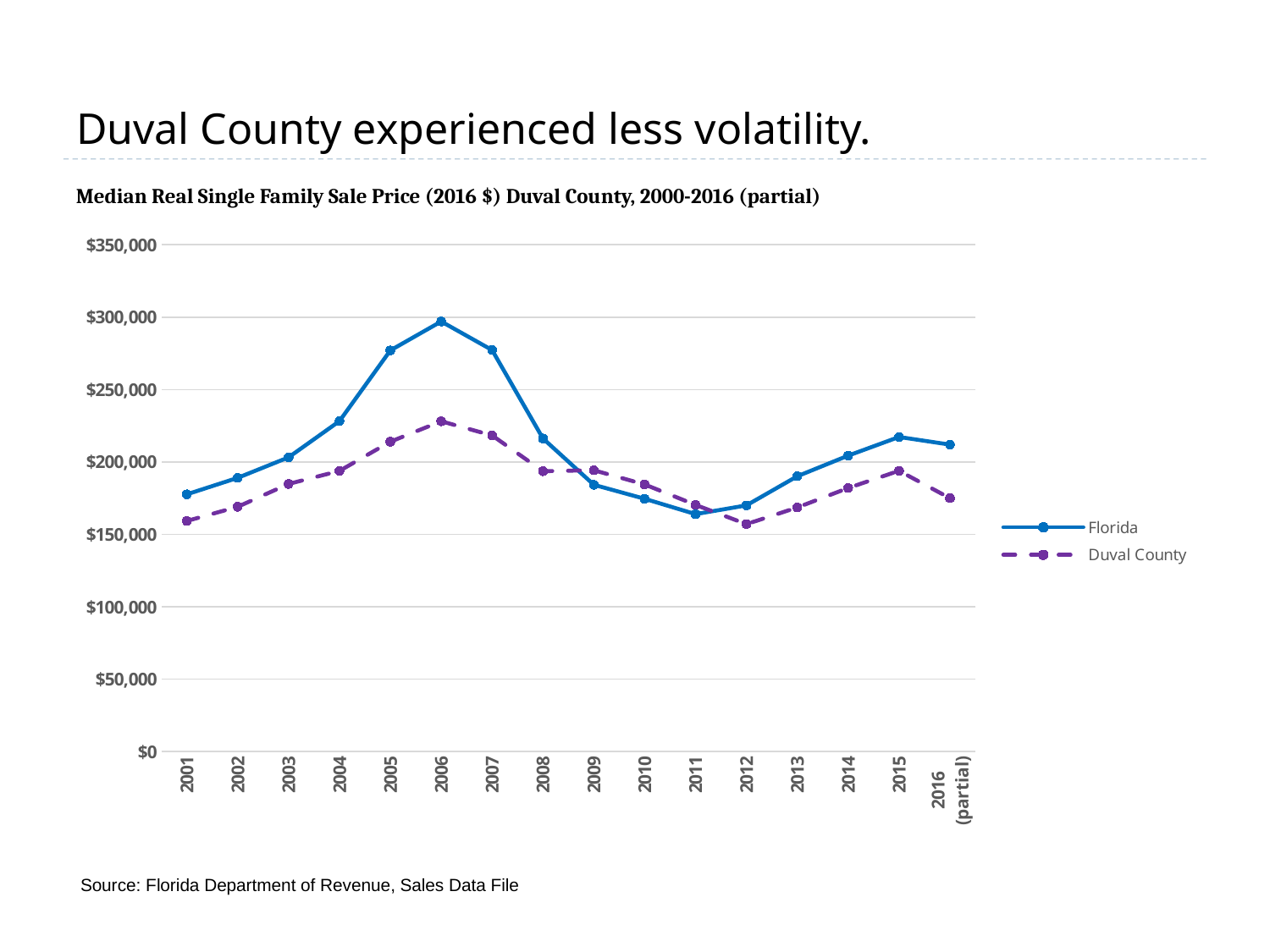
In which year does the Florida series reach its lowest value? 2011 Is the Duval County value for 2006 greater or less than $250,000? less In 2005, which series has the higher value, Florida or Duval County? Florida In which year does the Duval County series reach its highest value? 2006 What is the title of the chart? Median Real Single Family Sale Price (2016 $) Duval County, 2000-2016 (partial) How many series does the legend list? 2 Is the Florida value for 2006 greater or less than $250,000? greater Is the Florida value for 2011 greater or less than $200,000? less Does the Florida series rise or fall from 2006 to 2011? fall In which year does the Florida series reach its highest value? 2006 What kind of chart is shown on the slide? line chart How many years (points) are plotted along the x axis? 16